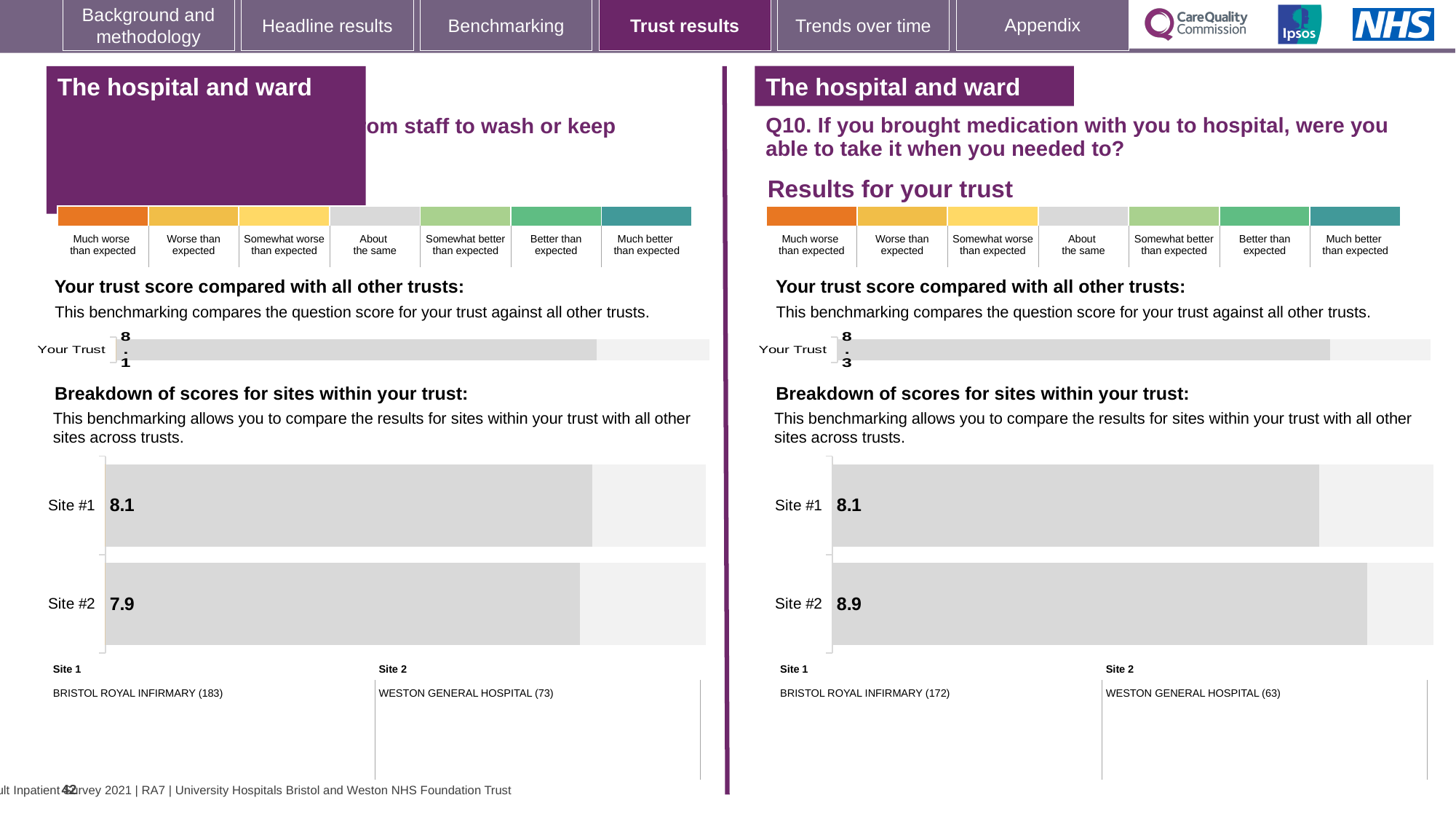
On the left-hand 'Breakdown of scores for sites within your trust' chart, which site has the higher score? Site #1 On the right-hand (Q10) 'Breakdown of scores for sites within your trust' chart, which site has the lower score? Site #1 What type of chart is used for the 'Breakdown of scores for sites within your trust' on the left-hand side of the slide? Bar chart On the left-hand site breakdown chart, what is the difference between the Site #1 and Site #2 scores? 0.2 On the left-hand 'Breakdown of scores for sites within your trust' chart, what is the score for Site #2? 7.9 How many sites are shown on the right-hand (Q10) 'Breakdown of scores for sites within your trust' chart? 2 On the right-hand (Q10) site breakdown chart, what is the difference between the Site #2 and Site #1 scores? 0.8 On the right-hand (Q10) site breakdown chart, which hospital is listed as Site 2? WESTON GENERAL HOSPITAL (63) On the right-hand (Q10) 'Your trust score compared with all other trusts' chart, what is the score for Your Trust? 8.3 On the left-hand 'Your trust score compared with all other trusts' chart, what is the score for Your Trust? 8.1 On the right-hand (Q10) 'Breakdown of scores for sites within your trust' chart, what is the score for Site #2? 8.9 On the right-hand (Q10) 'Breakdown of scores for sites within your trust' chart, what is the score for Site #1? 8.1